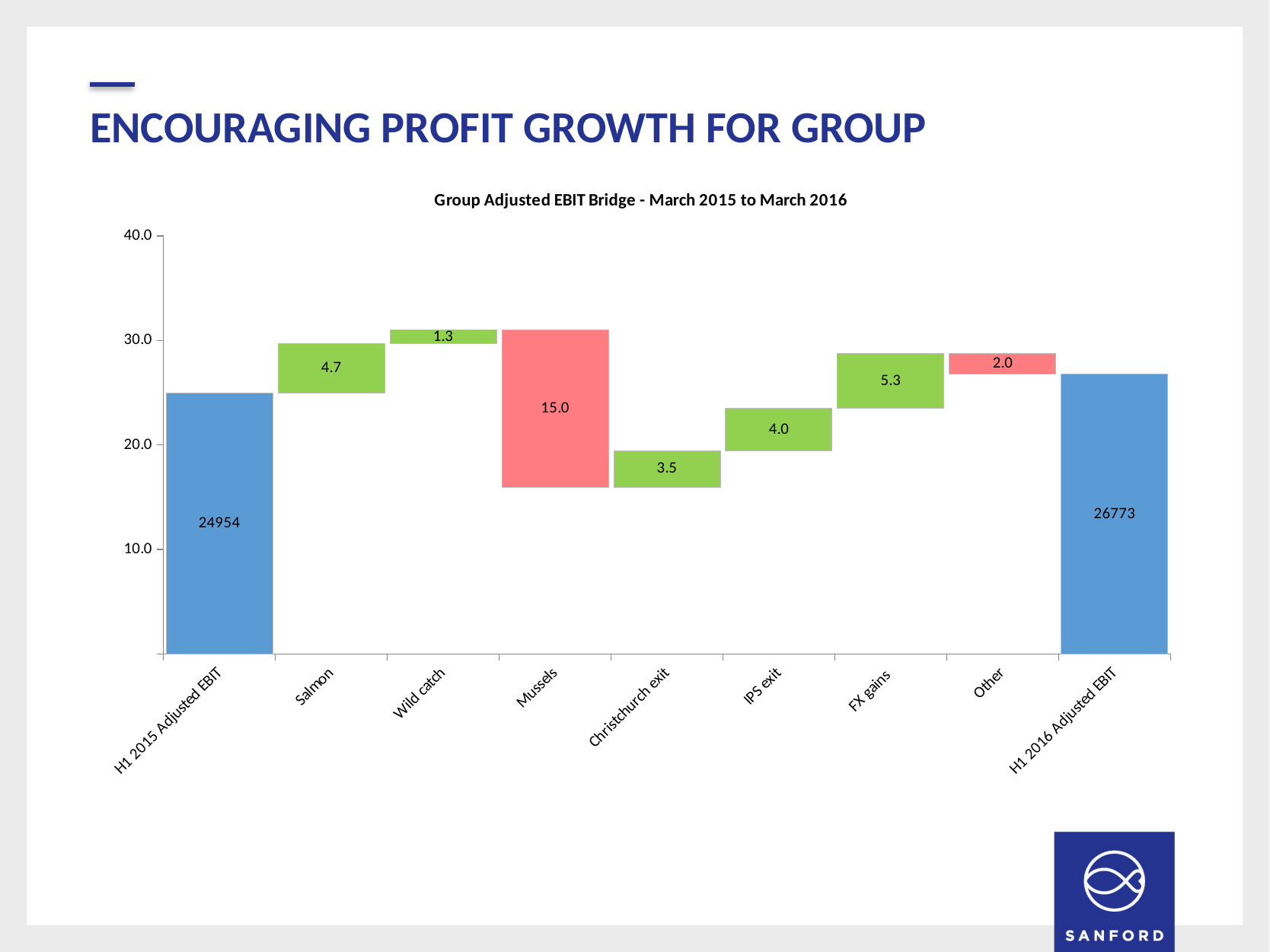
Among the bridge items between the two Adjusted EBIT bars, which has the largest labelled value? Mussels What is the value shown for H1 2015 Adjusted EBIT? 24954 What type of chart is shown on the slide? Bar chart (waterfall) What is the difference between the labelled values for FX gains and Salmon? 0.6 What value is labelled on the Mussels bar? 15.0 How many categories are shown on the x axis? 9 Which has the larger labelled value, Salmon or IPS exit? Salmon What is the value shown for H1 2016 Adjusted EBIT? 26773 Among the bridge items between the two Adjusted EBIT bars, which has the smallest labelled value? Wild catch What is the title of the chart? Group Adjusted EBIT Bridge - March 2015 to March 2016 What value is labelled on the FX gains bar? 5.3 What value is labelled on the Christchurch exit bar? 3.5